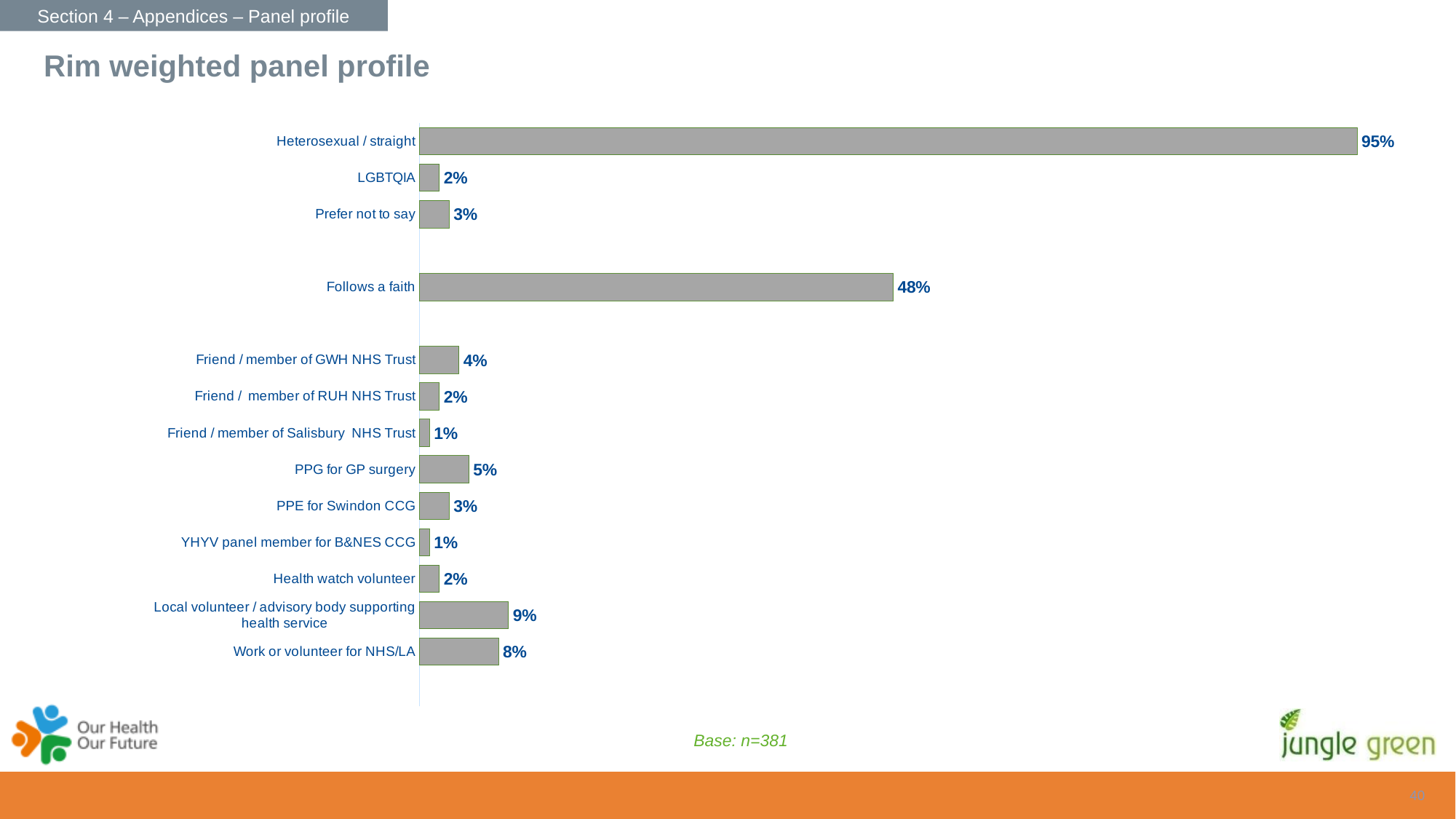
What is the difference between Heterosexual / straight and Follows a faith? 47% Which is larger, PPG for GP surgery or PPE for Swindon CCG? PPG for GP surgery What kind of chart is shown on the slide? Bar chart Which is larger, Friend / member of GWH NHS Trust or Friend / member of RUH NHS Trust? Friend / member of GWH NHS Trust What is the value for PPG for GP surgery? 5% What is the base size stated below the chart? n=381 Which category has the highest value? Heterosexual / straight How many categories are plotted in the chart? 13 What is the difference between Local volunteer / advisory body supporting health service and Work or volunteer for NHS/LA? 1% What is the value for Heterosexual / straight? 95% What is the value for Local volunteer / advisory body supporting health service? 9% What is the value for Follows a faith? 48%